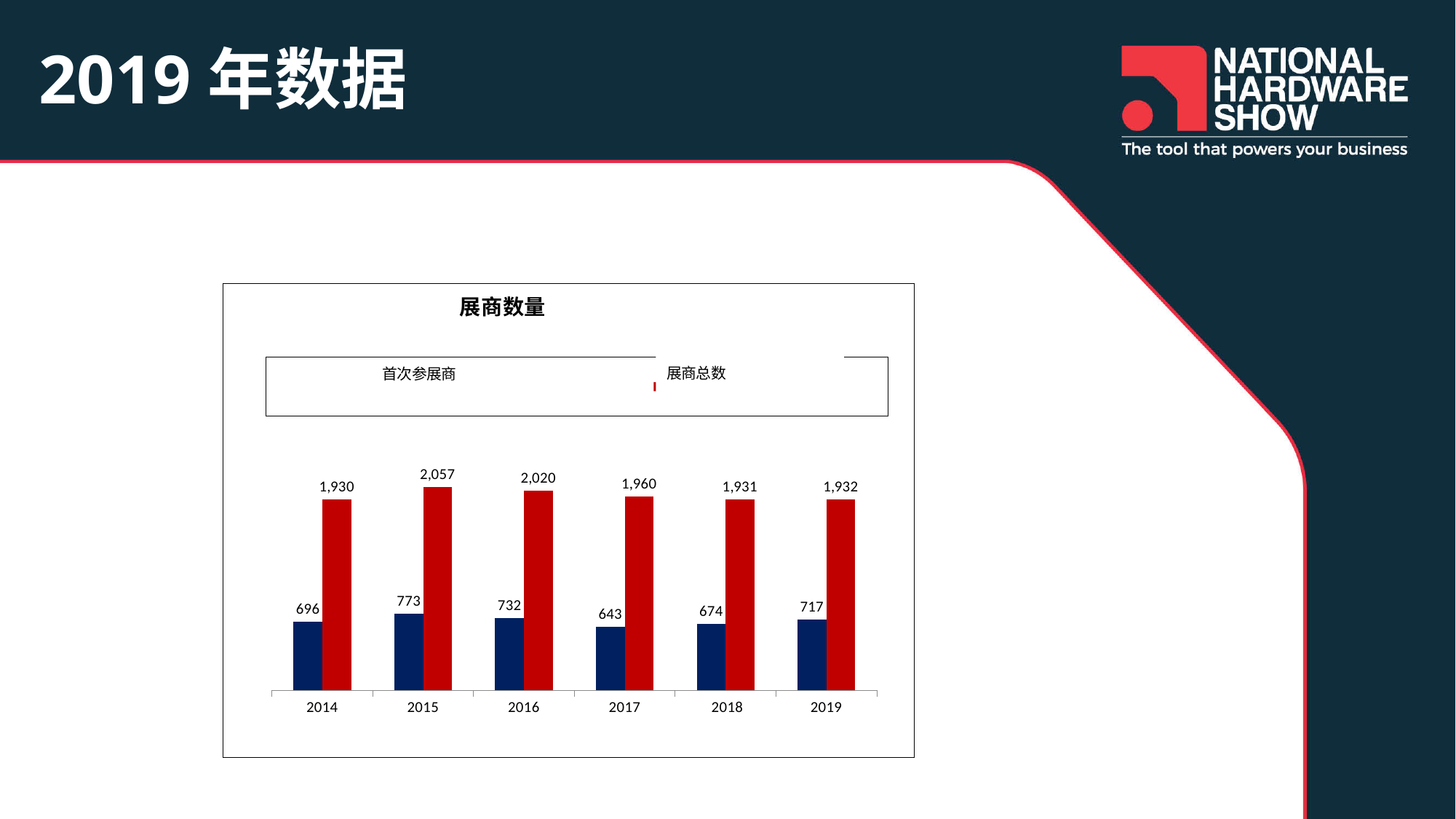
How many series does the legend list? 2 Which year has the highest value for 首次参展商? 2015 Which year has the lowest value for 首次参展商? 2017 What is the value for 展商总数 in 2015? 2,057 What is the difference between 展商总数 in 2016 and 2017? 60 What is the value for 首次参展商 in 2017? 643 How many years are shown on the x axis? 6 Which is larger: 首次参展商 in 2016 or in 2018? 2016 Which year has the highest value for 展商总数? 2015 What is the difference between 首次参展商 in 2015 and 2014? 77 What is the value for 展商总数 in 2014? 1,930 What is the value for 首次参展商 in 2019? 717